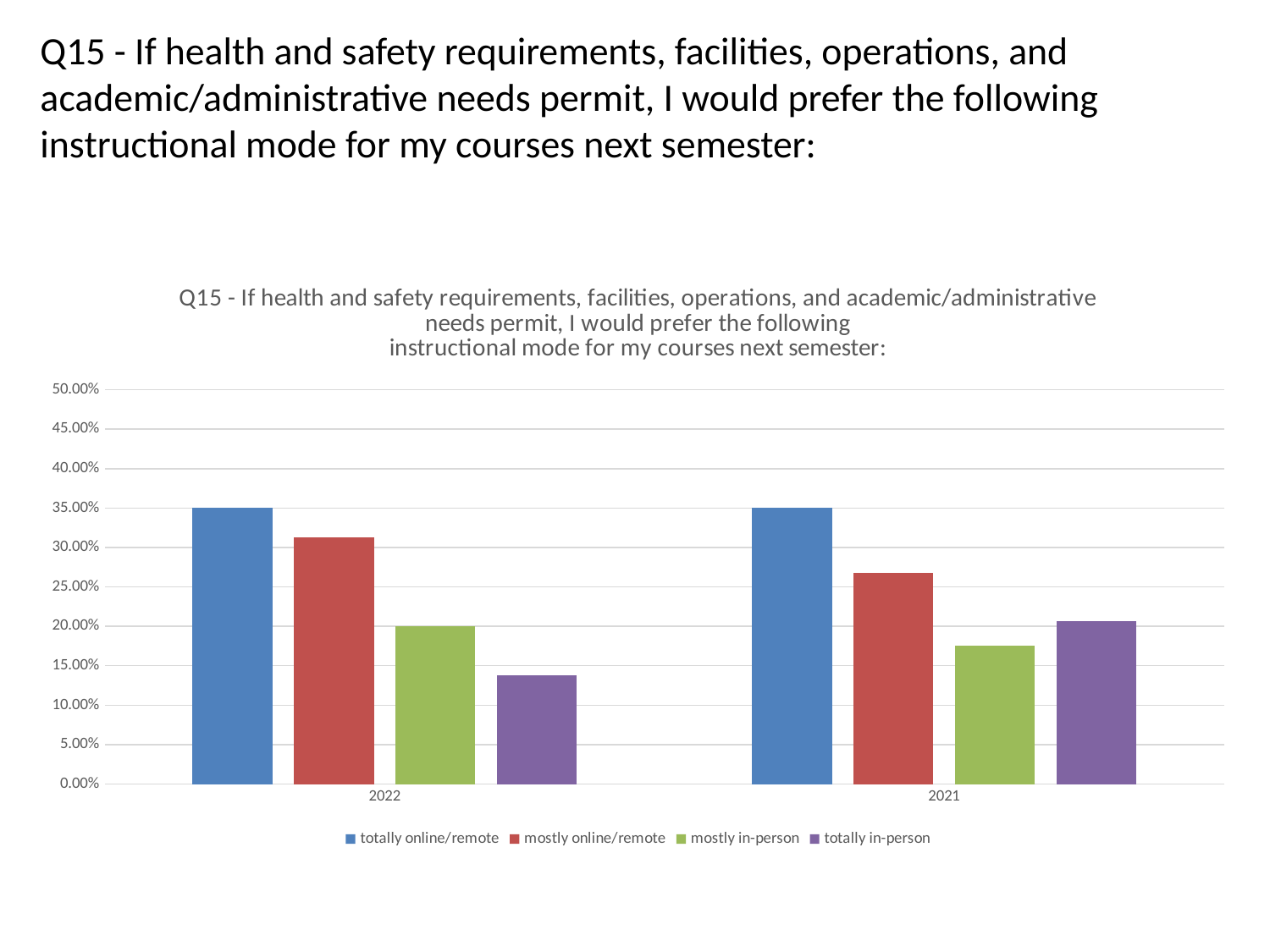
How many series does the legend list? 4 What kind of chart is shown on the slide? bar chart How many year categories are shown on the x axis? 2 Which is larger in 2021: totally in-person or mostly in-person? totally in-person Which is larger: mostly online/remote in 2022 or mostly online/remote in 2021? mostly online/remote in 2022 Is the value for mostly in-person in 2021 greater or less than 20.00%? less Which instructional mode has the lowest value for 2021? mostly in-person Which instructional mode has the lowest value for 2022? totally in-person Is the value for mostly online/remote in 2021 greater or less than 25.00%? greater Which instructional mode has the highest value for 2022? totally online/remote Is the value for totally in-person in 2022 greater or less than 15.00%? less